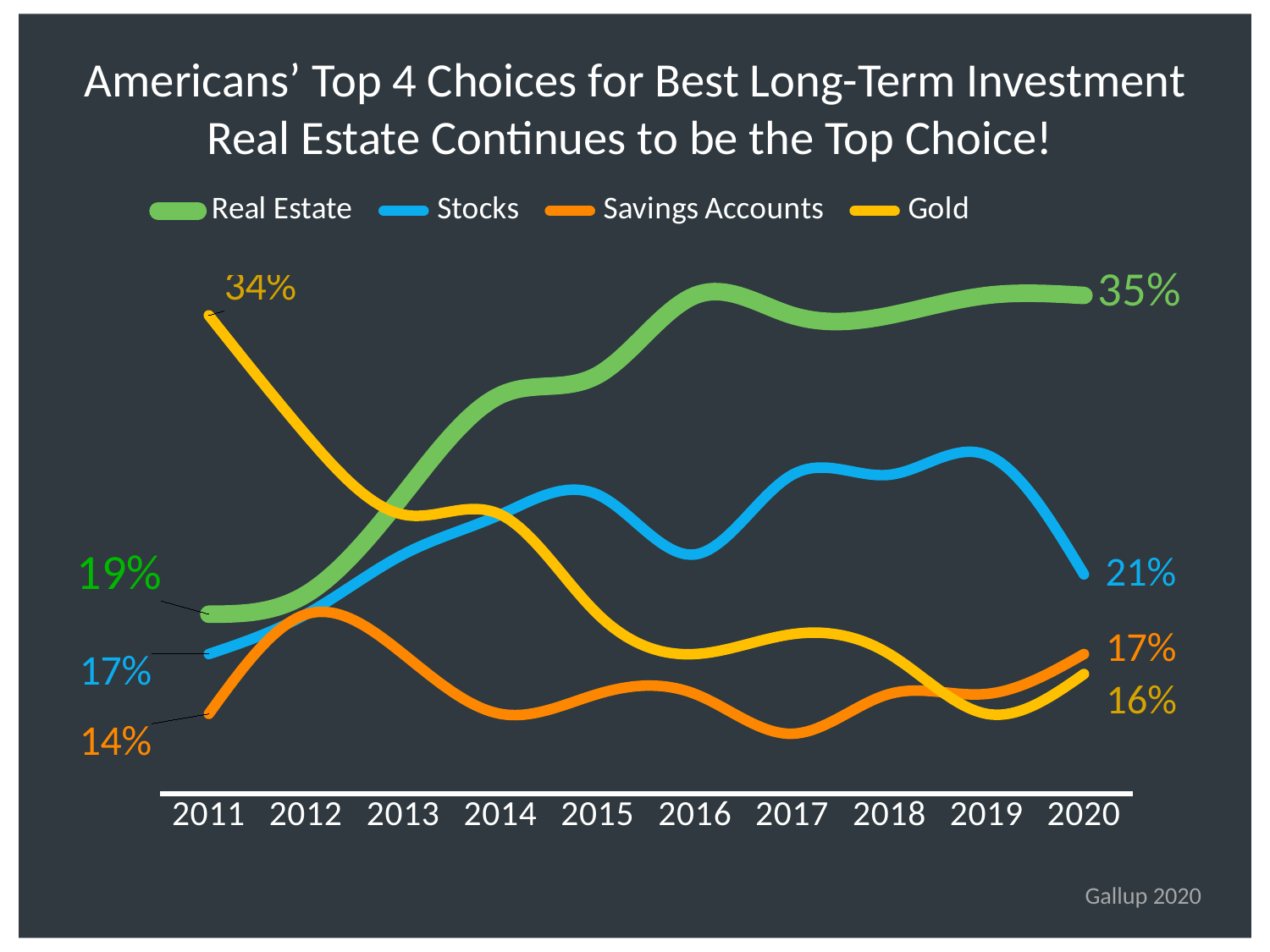
Does the Gold line rise or fall from 2011 to 2020? fall What is the value for Stocks in 2020? 21% How many years are shown on the x axis? 10 Which series has the highest value in 2011? Gold Which series has the lowest value in 2020? Gold Which is larger in 2020, the value for Savings Accounts or the value for Gold? Savings Accounts What is the difference between the Real Estate value in 2020 and its value in 2011? 16% What is the value for Gold in 2011? 34% What is the value for Savings Accounts in 2011? 14% How many series does the legend list? 4 What is the value for Real Estate in 2020? 35% What kind of chart is shown on the slide? line chart